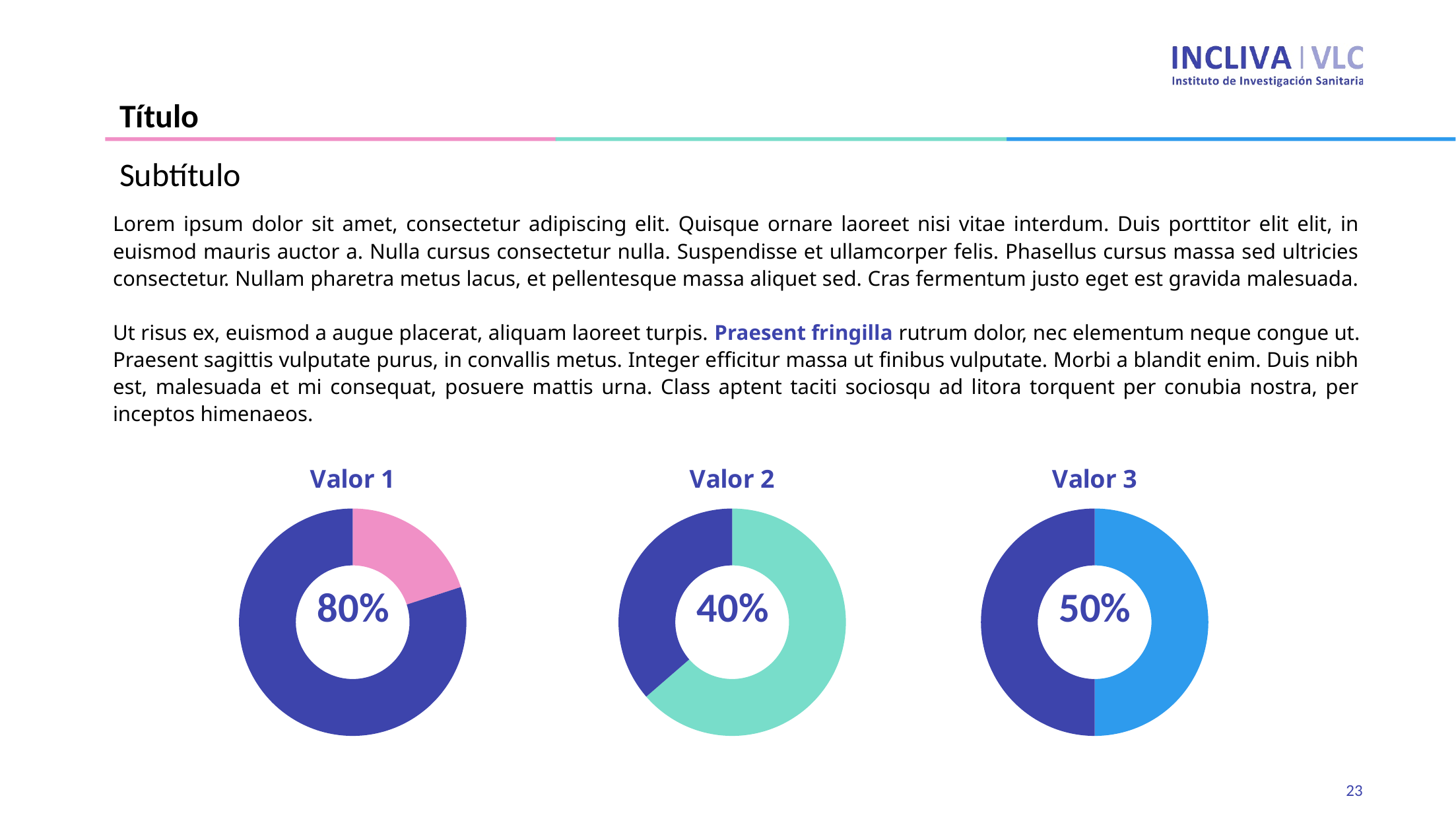
What kind of chart is used to display Valor 1, Valor 2 and Valor 3? Donut chart What is the difference between the percentage shown for Valor 3 and the percentage shown for Valor 2? 10% What colour is the smaller slice in the Valor 1 donut chart? Pink How many donut charts are shown on the slide? 3 Which shows a larger percentage, Valor 2 or Valor 3? Valor 3 What value is shown in the centre of the Valor 2 donut chart? 40% Which of the three donut charts (Valor 1, Valor 2, Valor 3) shows the highest percentage? Valor 1 Is the percentage shown for Valor 1 greater or less than 50%? greater What value is shown in the centre of the Valor 3 donut chart? 50% What value is shown in the centre of the Valor 1 donut chart? 80% What is the difference between the percentage shown for Valor 1 and the percentage shown for Valor 2? 40% Which of the three donut charts (Valor 1, Valor 2, Valor 3) shows the lowest percentage? Valor 2